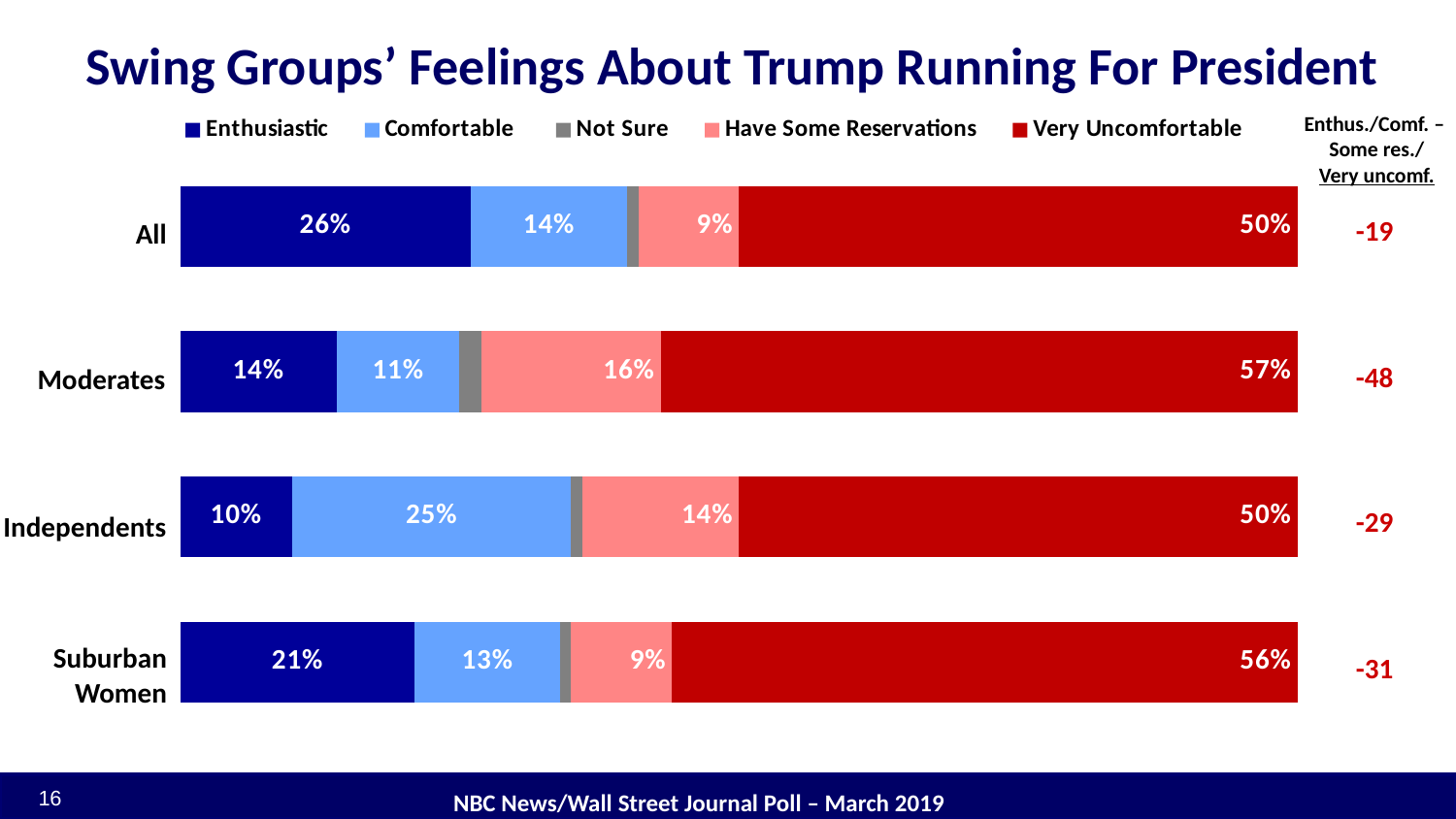
Which group has the lowest Enthusiastic percentage? Independents What percentage of Moderates are Very Uncomfortable with Trump running for president? 57% What percentage of Independents are Comfortable with Trump running for president? 25% Which group has the highest Very Uncomfortable percentage? Moderates How many series does the legend list? 5 How many groups are shown in the chart? 4 What percentage of All respondents Have Some Reservations about Trump running for president? 9% What is the difference between the Enthusiastic percentage for All and for Moderates? 12% What colour represents the Very Uncomfortable series? Red Which is larger: the Comfortable percentage for Independents or for Suburban Women? Independents What percentage of Suburban Women are Enthusiastic about Trump running for president? 21% What kind of chart is shown on the slide? Stacked bar chart